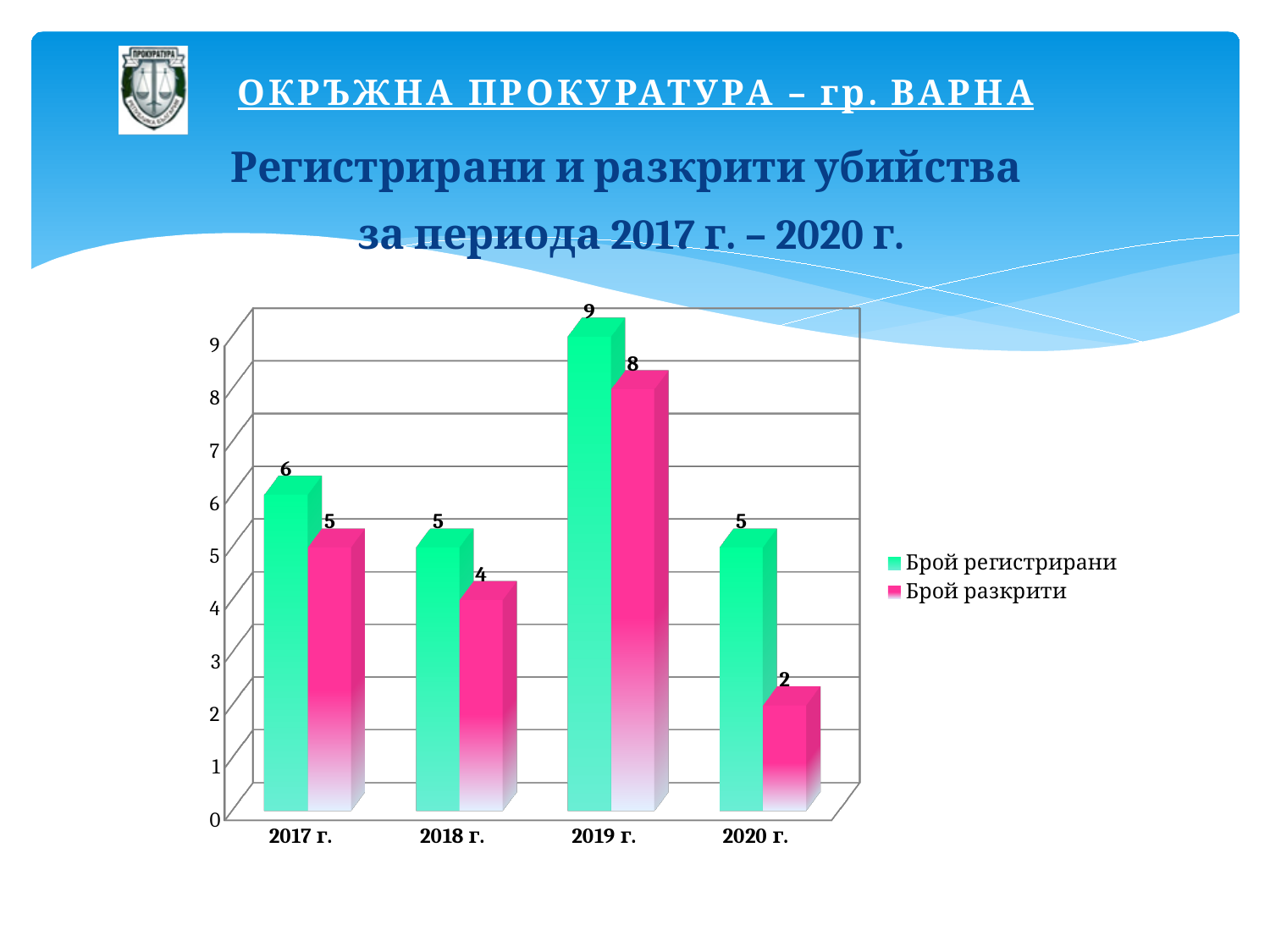
What is the value of "Брой регистрирани" for 2019 г.? 9 What kind of chart is shown on the slide? bar chart How many years are shown on the x axis? 4 What is the value of "Брой разкрити" for 2018 г.? 4 Which colour represents "Брой разкрити" in the chart? pink What is the value of "Брой разкрити" for 2020 г.? 2 What is the difference between "Брой регистрирани" and "Брой разкрити" in 2020 г.? 3 Which is larger: "Брой разкрити" in 2017 г. or "Брой разкрити" in 2019 г.? 2019 г. Which year has the lowest value for "Брой разкрити"? 2020 г. How many series does the legend list? 2 Which year has the highest value for "Брой регистрирани"? 2019 г. What is the difference between "Брой регистрирани" in 2019 г. and in 2018 г.? 4